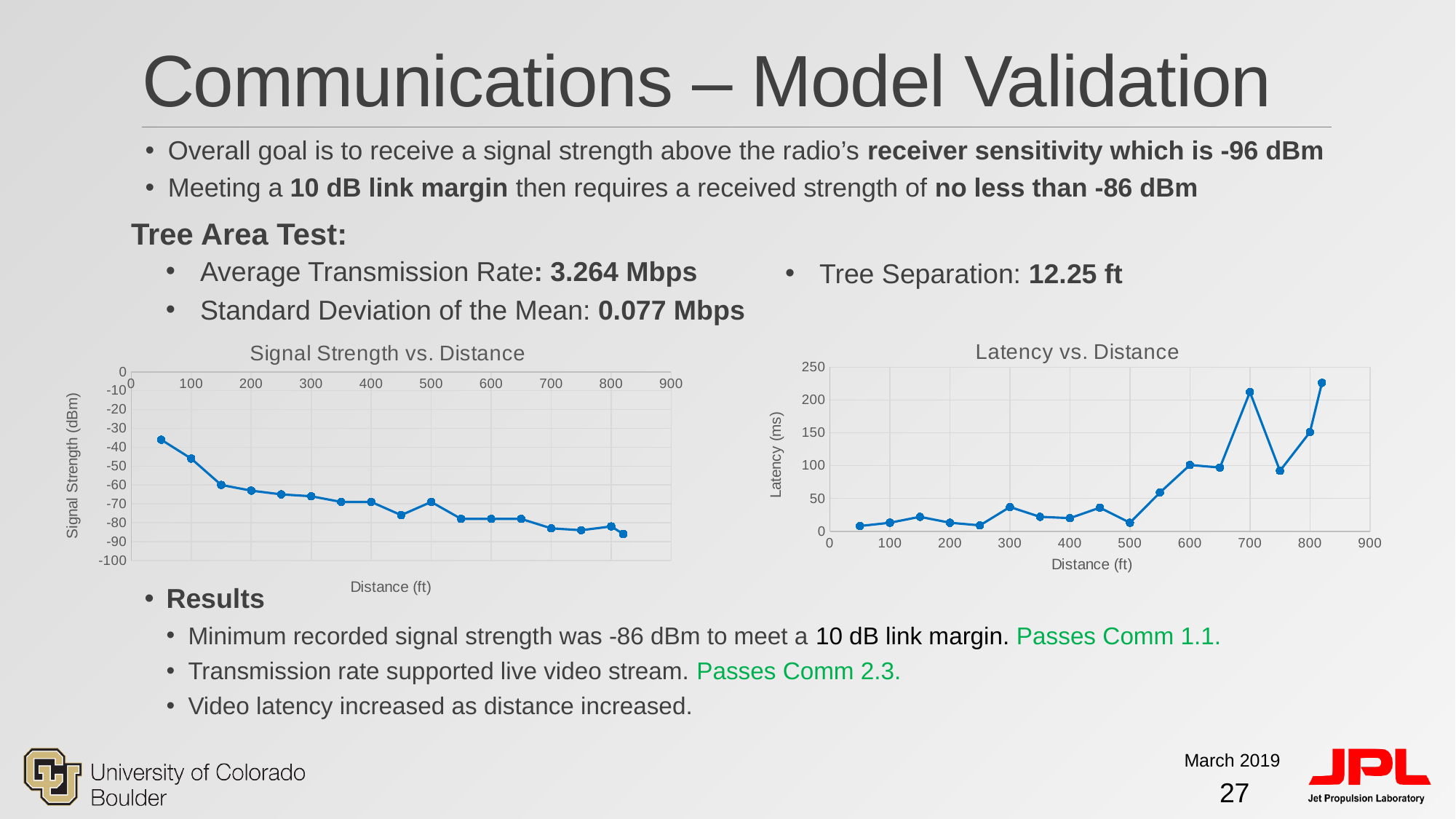
In the Signal Strength vs. Distance chart, do the values generally rise or fall as distance increases? fall In the Latency vs. Distance chart, is the value at 300 ft greater or less than 50? less What is the y-axis label of the Latency vs. Distance chart? Latency (ms) In the Signal Strength vs. Distance chart, is the value at 50 ft greater or less than -40? greater In the Latency vs. Distance chart, which is larger, the value at 700 ft or the value at 750 ft? 700 ft In the Signal Strength vs. Distance chart, is the value at 450 ft greater or less than -70? less What is the y-axis label of the Signal Strength vs. Distance chart? Signal Strength (dBm) What kind of chart is the Latency vs. Distance chart? line chart What kind of chart is the Signal Strength vs. Distance chart? line chart In the Latency vs. Distance chart, do the values generally rise or fall as distance increases? rise